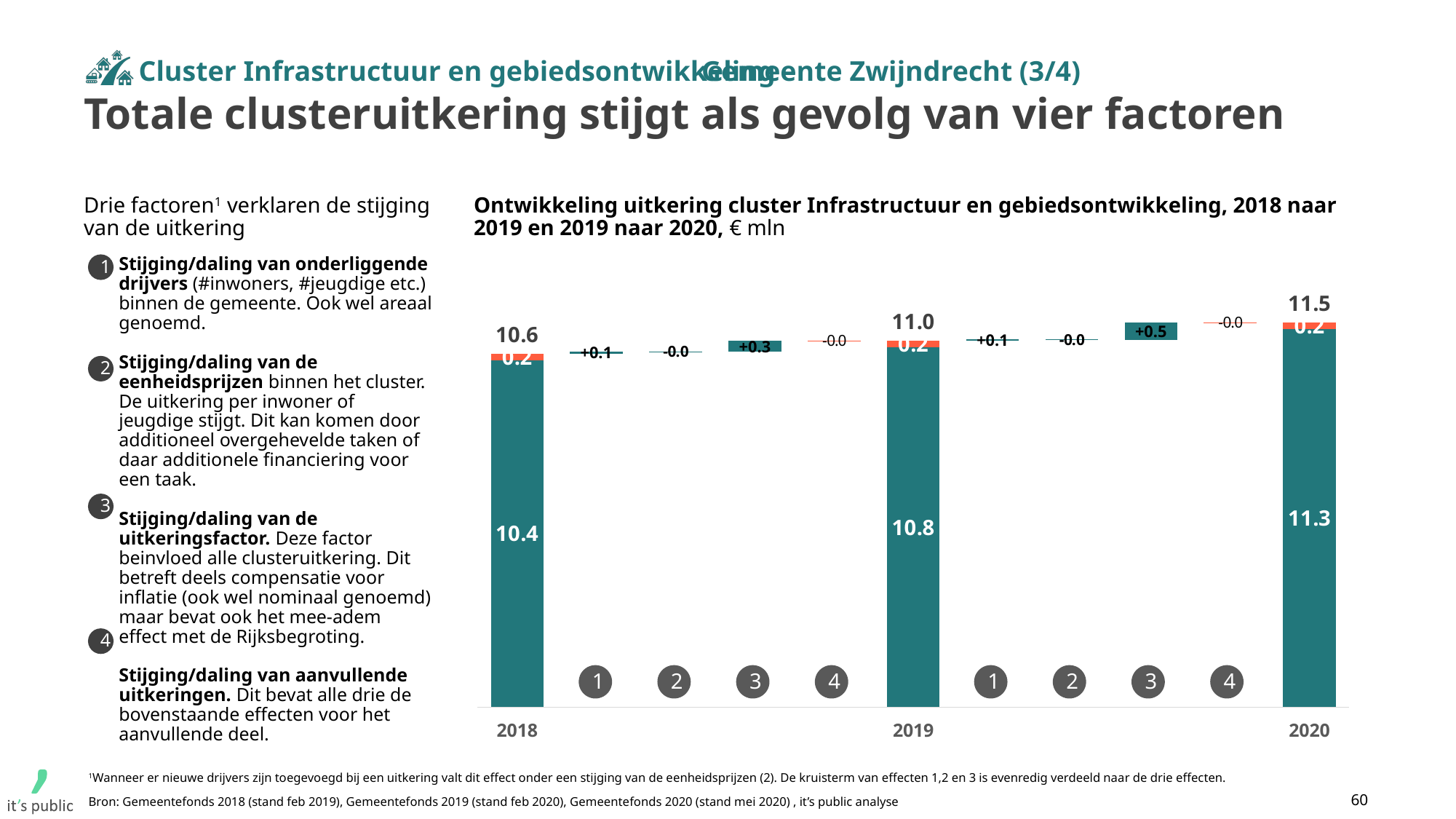
Which year has the highest total uitkering? 2020 Which year has the lowest total uitkering? 2018 What is the value of the large teal segment of the 2019 bar? 10.8 What is the difference between the 2020 total (11.5) and the 2018 total (10.6)? 0.9 What is the value of the factor 1 step between 2018 and 2019? +0.1 What unit is stated in the chart title? € mln Do the total uitkering values rise or fall from 2018 to 2020? rise What is the value of the factor 3 step between 2018 and 2019? +0.3 Is the factor 3 step between 2019 and 2020 larger or smaller than the factor 3 step between 2018 and 2019? larger What is the total uitkering shown for 2020? 11.5 What is the value of the factor 3 step between 2019 and 2020? +0.5 What is the total uitkering shown for 2018? 10.6